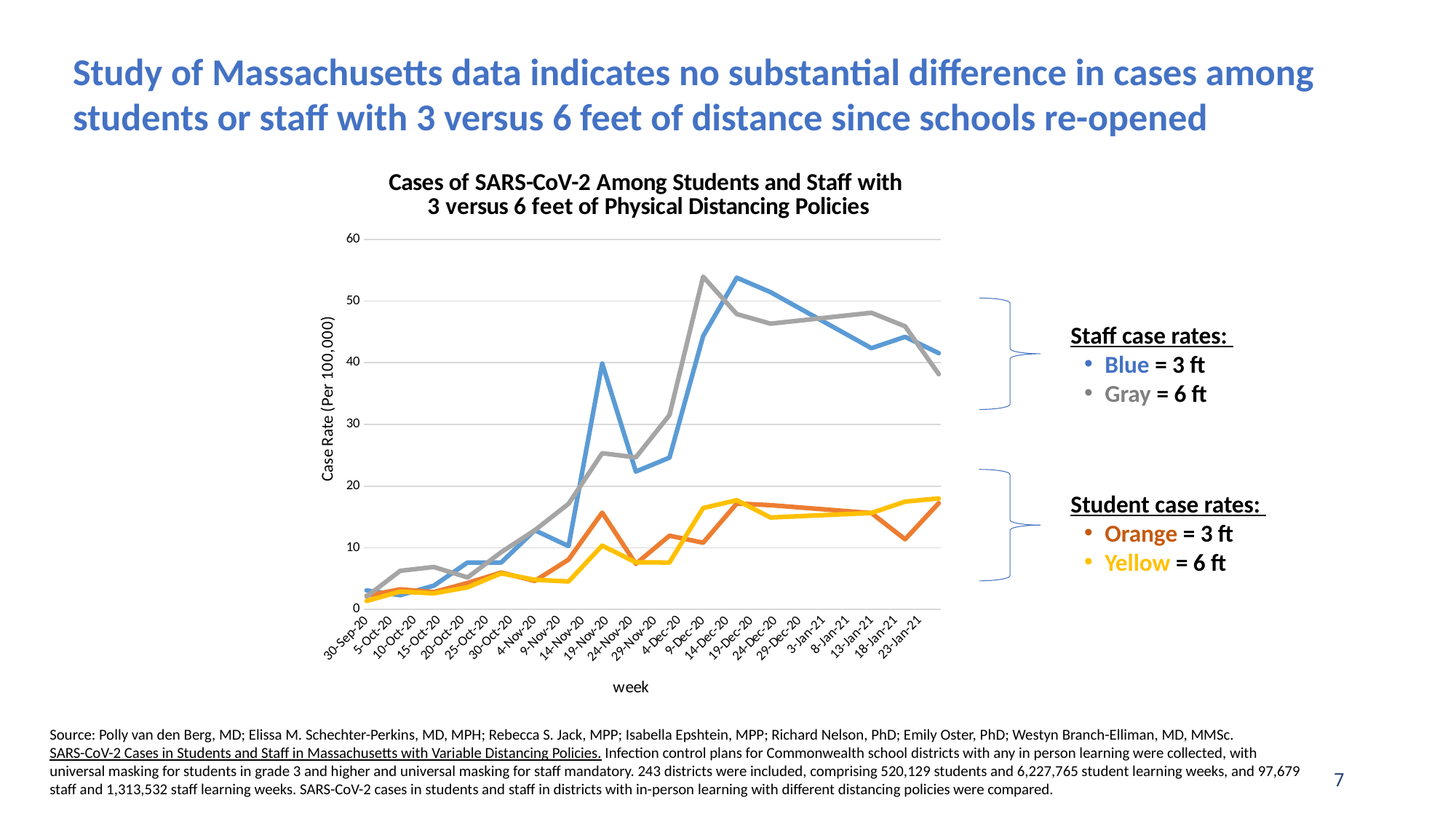
At 18-Jan-21, which is higher: the orange (student, 3 ft) line or the yellow (student, 6 ft) line? yellow (student, 6 ft) At 19-Nov-20, which is higher: the blue (staff, 3 ft) line or the gray (staff, 6 ft) line? blue (staff, 3 ft) Is the blue (staff, 3 ft) line's value at 19-Nov-20 greater or less than 30? greater What kind of chart is shown on the slide? line chart What is the title of the chart? Cases of SARS-CoV-2 Among Students and Staff with 3 versus 6 feet of Physical Distancing Policies Is the yellow (student, 6 ft) line's value at 23-Jan-21 greater or less than 20? less What is the label on the y axis of the chart? Case Rate (Per 100,000) Is the gray (staff, 6 ft) line's value at 23-Jan-21 greater or less than 40? less How many series (lines) does the chart plot, according to the annotations beside it? 4 Does the blue (staff, 3 ft) line rise or fall between 14-Dec-20 and 23-Jan-21? fall How many weekly dates are labelled along the x axis of the chart? 24